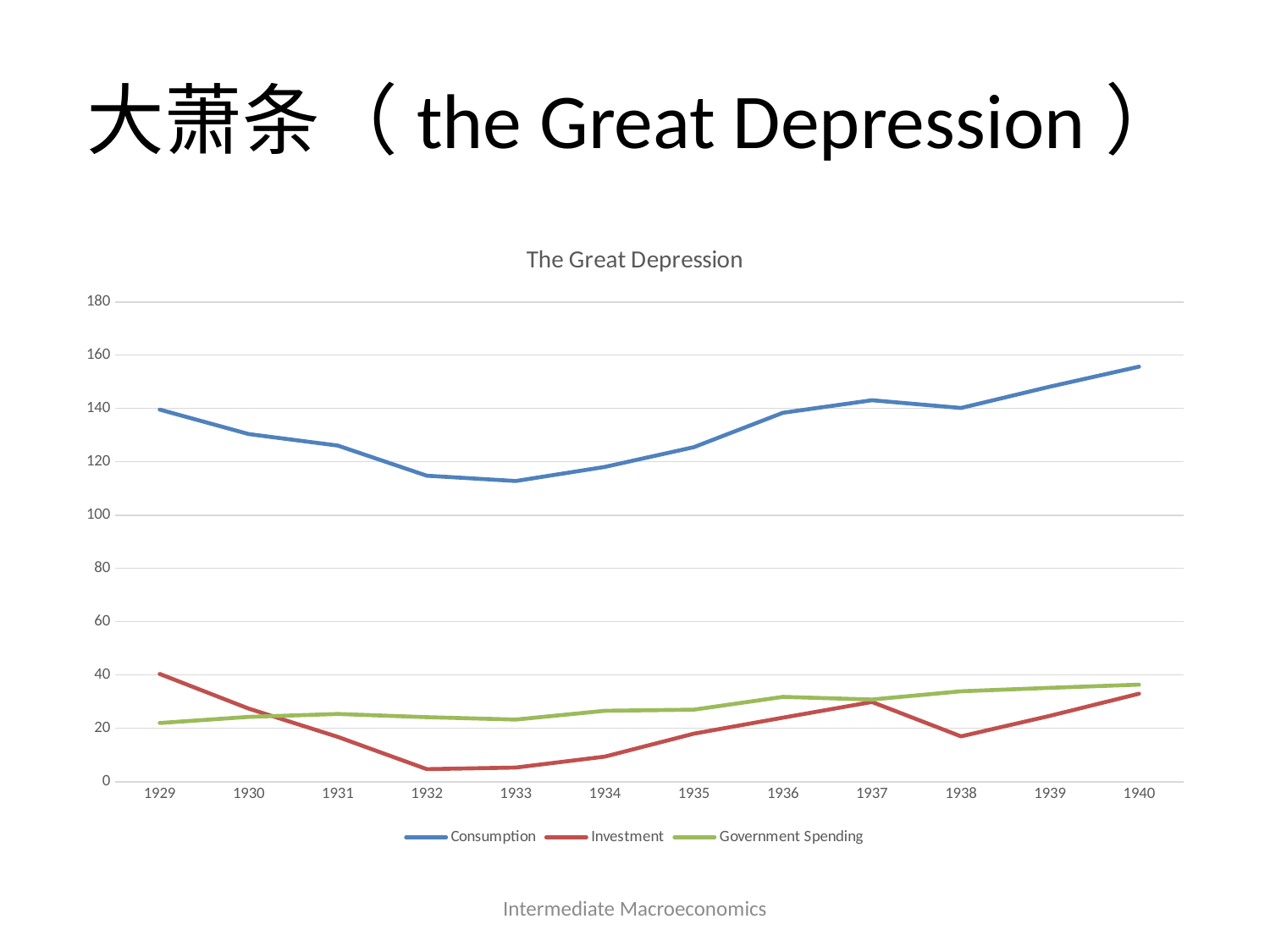
In which year is Investment highest? 1929 Is the value for Consumption in 1929 greater or less than 120? greater Is the value for Investment in 1932 greater or less than 20? less In 1938, which is larger: Investment or Government Spending? Government Spending Is the value for Investment in 1929 greater or less than 20? greater How many series does the legend list? 3 What kind of chart is shown on the slide? line chart In which year is Consumption highest? 1940 How many years are shown on the x axis? 12 Does Consumption rise or fall from 1933 to 1940? rise What is the title of the chart? The Great Depression